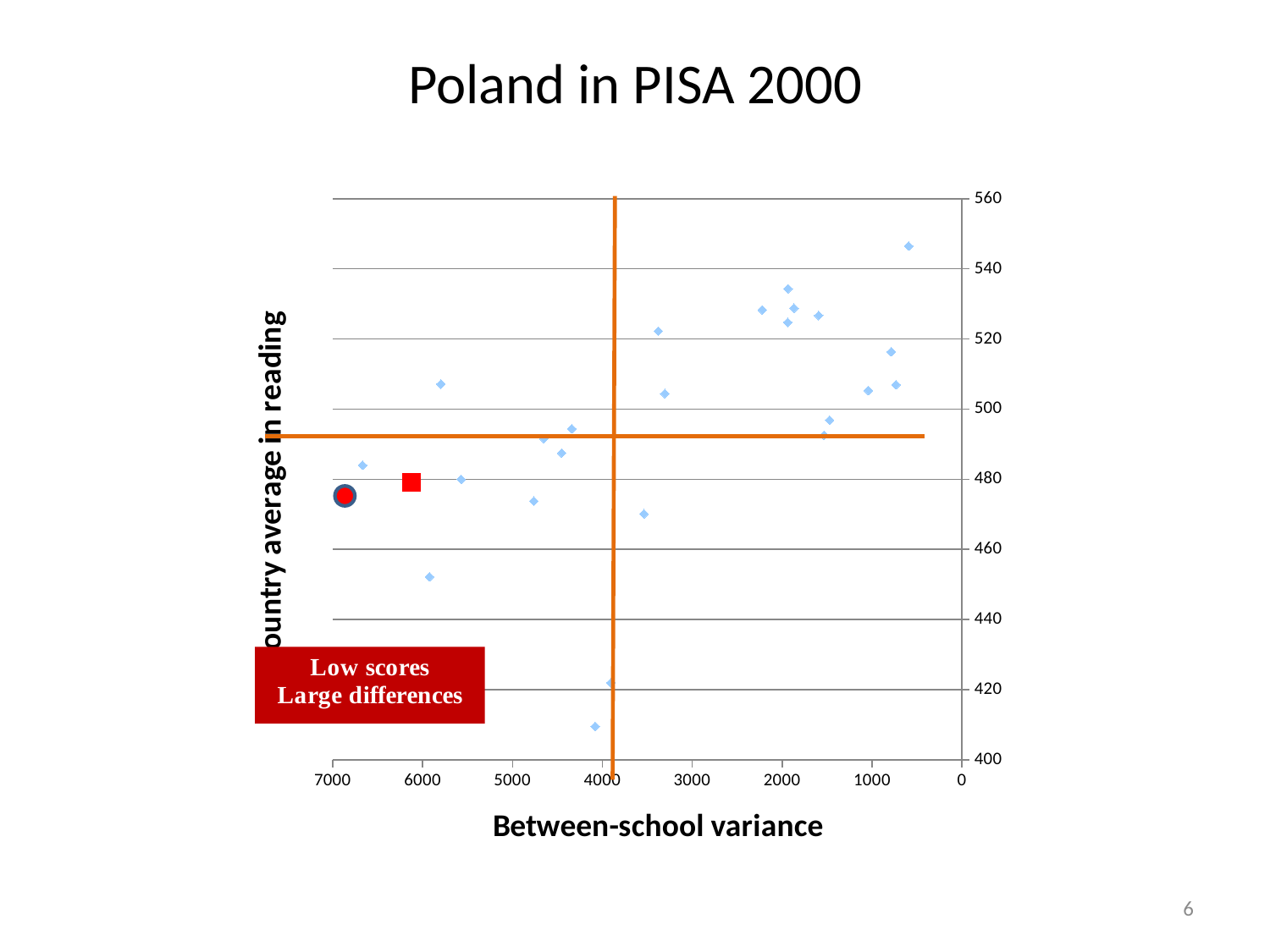
What is the title of the chart? Poland in PISA 2000 Is the reading average of the highest point on the chart greater or less than 540? greater Is the reading average for the red circled point greater or less than 460? greater Is the reading average of the lowest point on the chart greater or less than 420? less What is the leftmost value shown on the horizontal axis? 7000 What is the lowest value shown on the vertical axis? 400 What kind of chart is shown on the slide? scatter chart What is the highest value shown on the vertical axis? 560 What is the label of the horizontal axis? Between-school variance